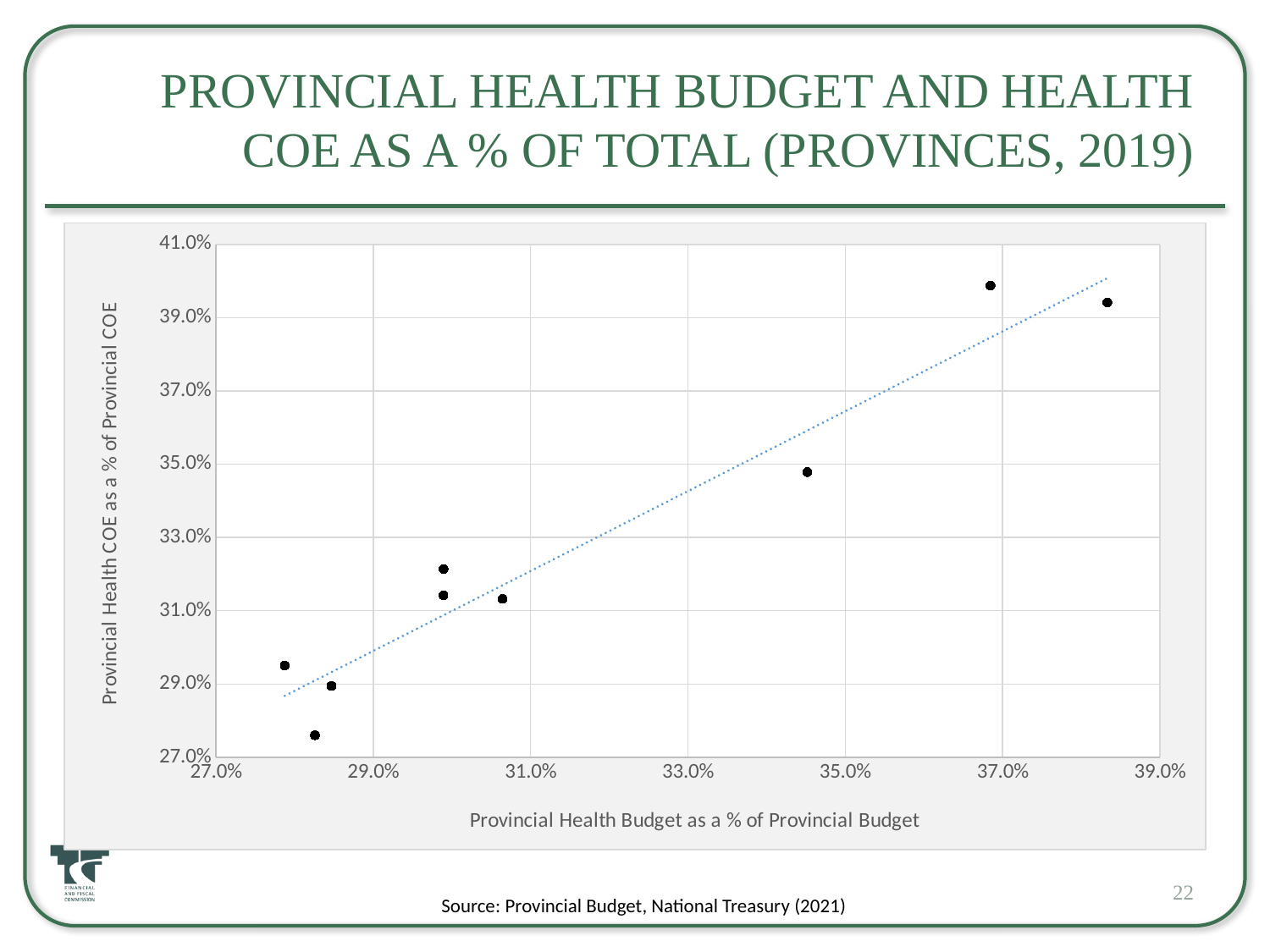
How many plotted points have a Provincial Health Budget as a % of Provincial Budget below 29.0%? 3 How many plotted points have a Provincial Health Budget as a % of Provincial Budget above 33.0%? 3 Is the vertical-axis value of the lowest plotted point greater or less than 29.0%? less How many data points are plotted on the chart? 9 Is the vertical-axis value of the highest plotted point greater or less than 39.0%? greater What is the title of the horizontal axis? Provincial Health Budget as a % of Provincial Budget As Provincial Health Budget as a % of Provincial Budget increases along the x axis, do the plotted values of Provincial Health COE as a % of Provincial COE generally rise or fall? Rise What is the title of the vertical axis? Provincial Health COE as a % of Provincial COE What kind of chart is shown on the slide? Scatter chart Is the horizontal-axis value of the rightmost plotted point greater or less than 37.0%? greater